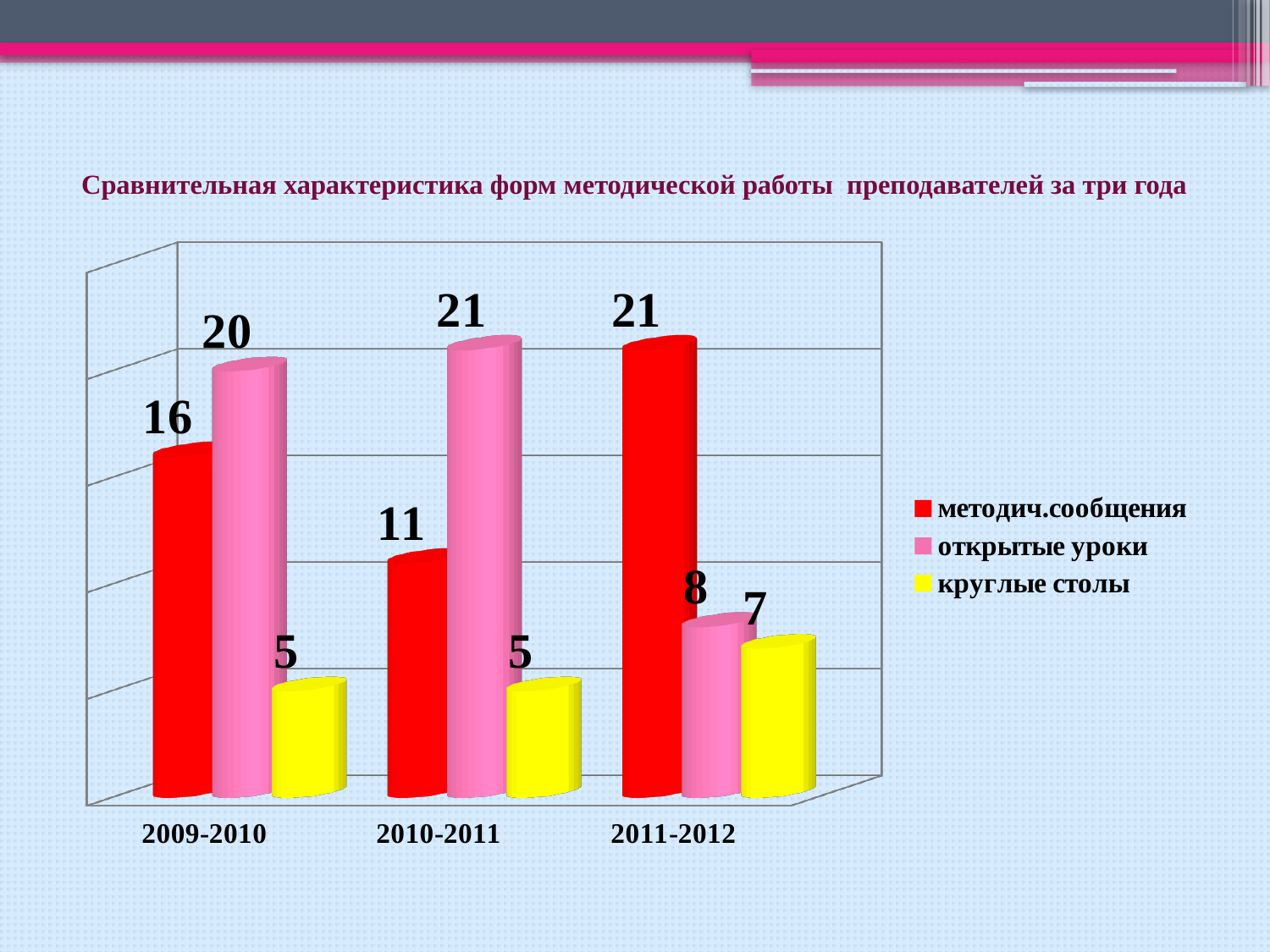
Does the value for открытые уроки rise or fall from 2010-2011 to 2011-2012? fall In which year is the value for методич.сообщения the highest? 2011-2012 In which year is the value for методич.сообщения the lowest? 2010-2011 What is the value for методич.сообщения in 2009-2010? 16 What is the value for открытые уроки in 2010-2011? 21 Which colour represents круглые столы in the legend? yellow What kind of chart is shown on the slide? bar chart How many year categories are shown on the x axis? 3 How many series does the legend list? 3 What is the value for круглые столы in 2011-2012? 7 Which is larger in 2011-2012: методич.сообщения or открытые уроки? методич.сообщения What is the difference between открытые уроки and методич.сообщения in 2010-2011? 10